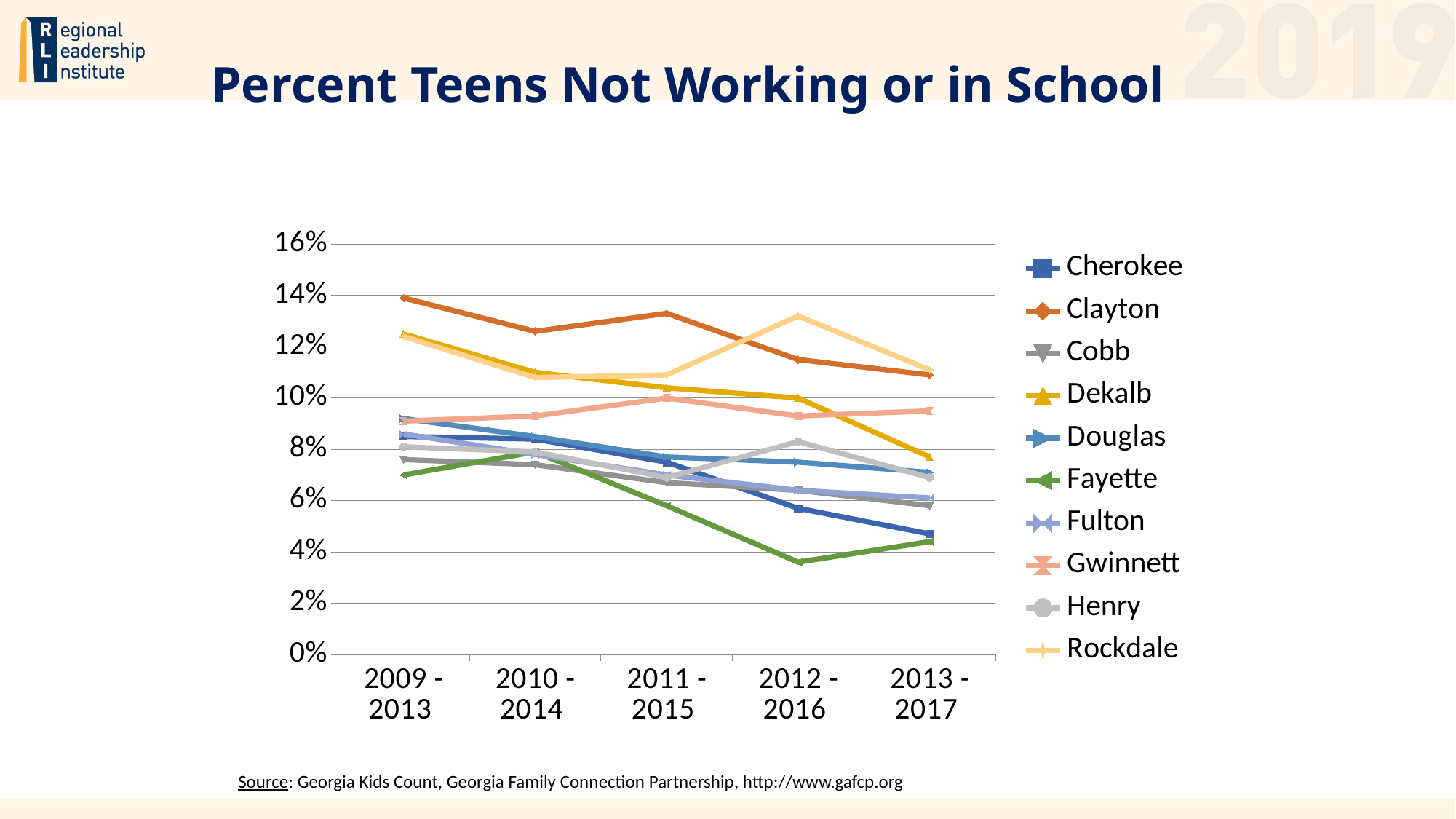
Which county has the highest value in 2010 - 2014? Clayton Does the value for Clayton rise or fall from 2009 - 2013 to 2013 - 2017? fall Is the value for Cherokee in 2013 - 2017 greater or less than 6%? less Is the value for Fayette in 2012 - 2016 greater or less than 4%? less Which is larger in 2012 - 2016, the value for Rockdale or the value for Clayton? Rockdale What kind of chart is shown on the slide? line chart How many time periods are shown on the x axis? 5 Which county has the highest value in 2009 - 2013? Clayton How many series does the legend list? 10 Which county has the lowest value in 2012 - 2016? Fayette Which county has the highest value in 2012 - 2016? Rockdale Is the value for Clayton in 2009 - 2013 greater or less than 12%? greater